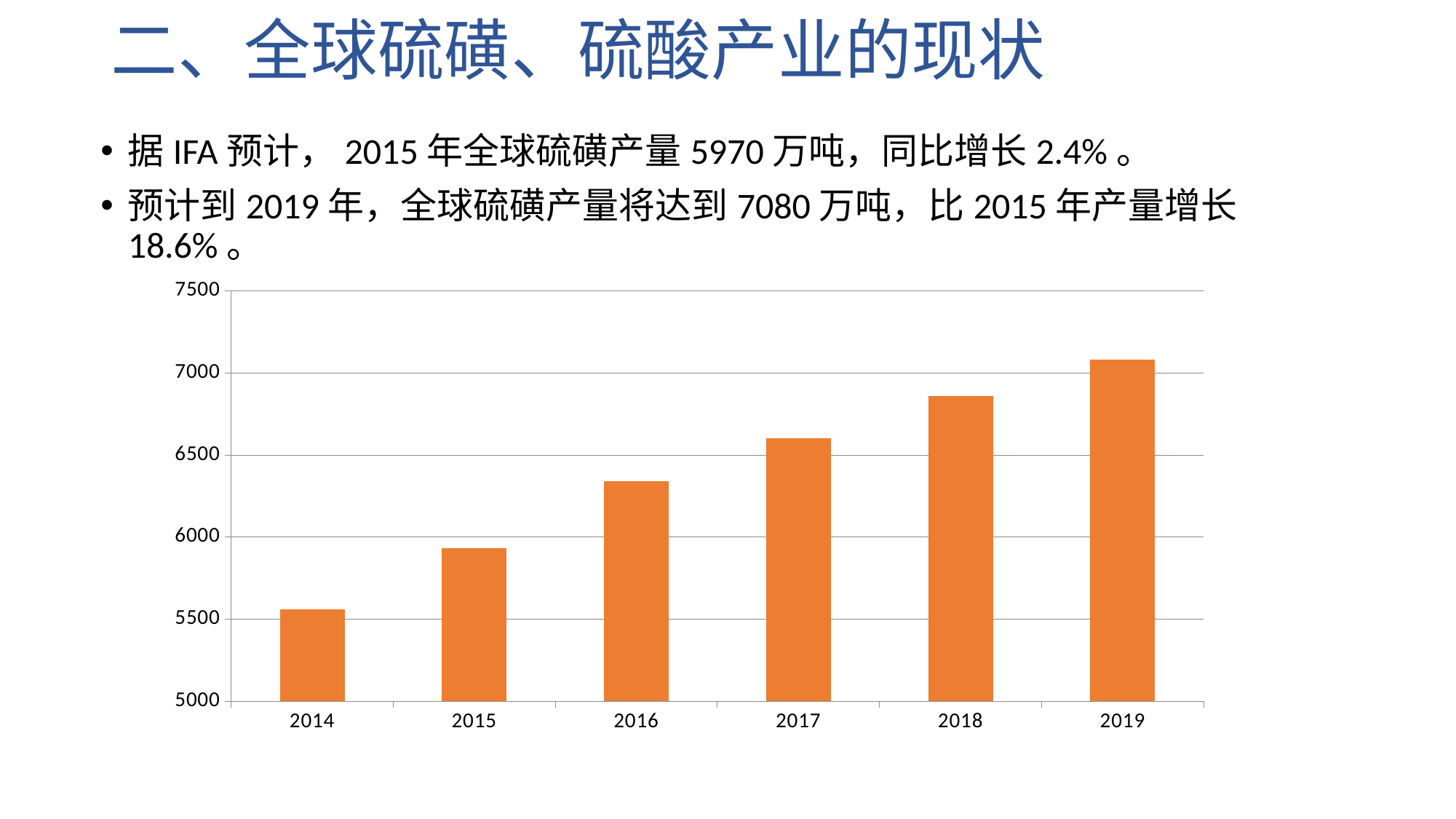
Which year has the lowest bar in the chart? 2014 How many years are shown on the x axis of the chart? 6 Is the value for 2016 greater or less than 6000? greater What kind of chart is shown on the slide? bar chart Which year has the highest bar in the chart? 2019 Is the value for 2017 greater or less than 6500? greater Which is larger, the value for 2016 or the value for 2018? 2018 Is the value for 2015 greater or less than 6000? less Do the values rise or fall from 2014 to 2019 in the chart? rise What colour are the bars in the chart? orange